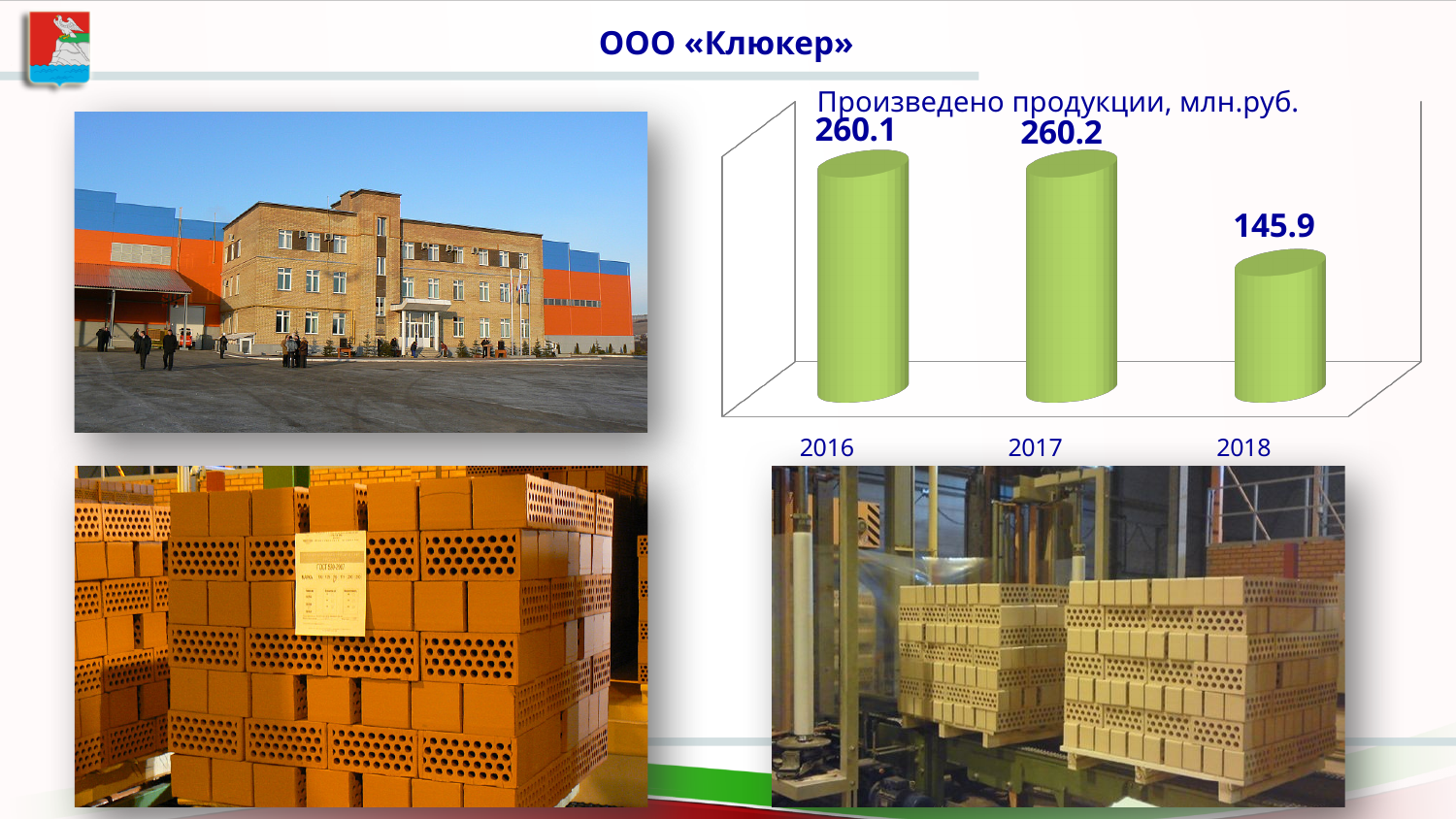
What value is shown for 2016 in the chart "Произведено продукции, млн.руб."? 260.1 Which is larger, the value for 2016 or the value for 2018? 2016 What is the title of the chart? Произведено продукции, млн.руб. What value is shown for 2018 in the chart? 145.9 Which year has the lowest value in the chart? 2018 What value is shown for 2017 in the chart? 260.2 How many years are shown in the chart? 3 Which year has the highest value in the chart? 2017 What is the difference between the values for 2017 and 2018? 114.3 What kind of chart is shown on the slide? bar chart What is the difference between the values for 2016 and 2018? 114.2 Does the value rise or fall from 2017 to 2018? fall